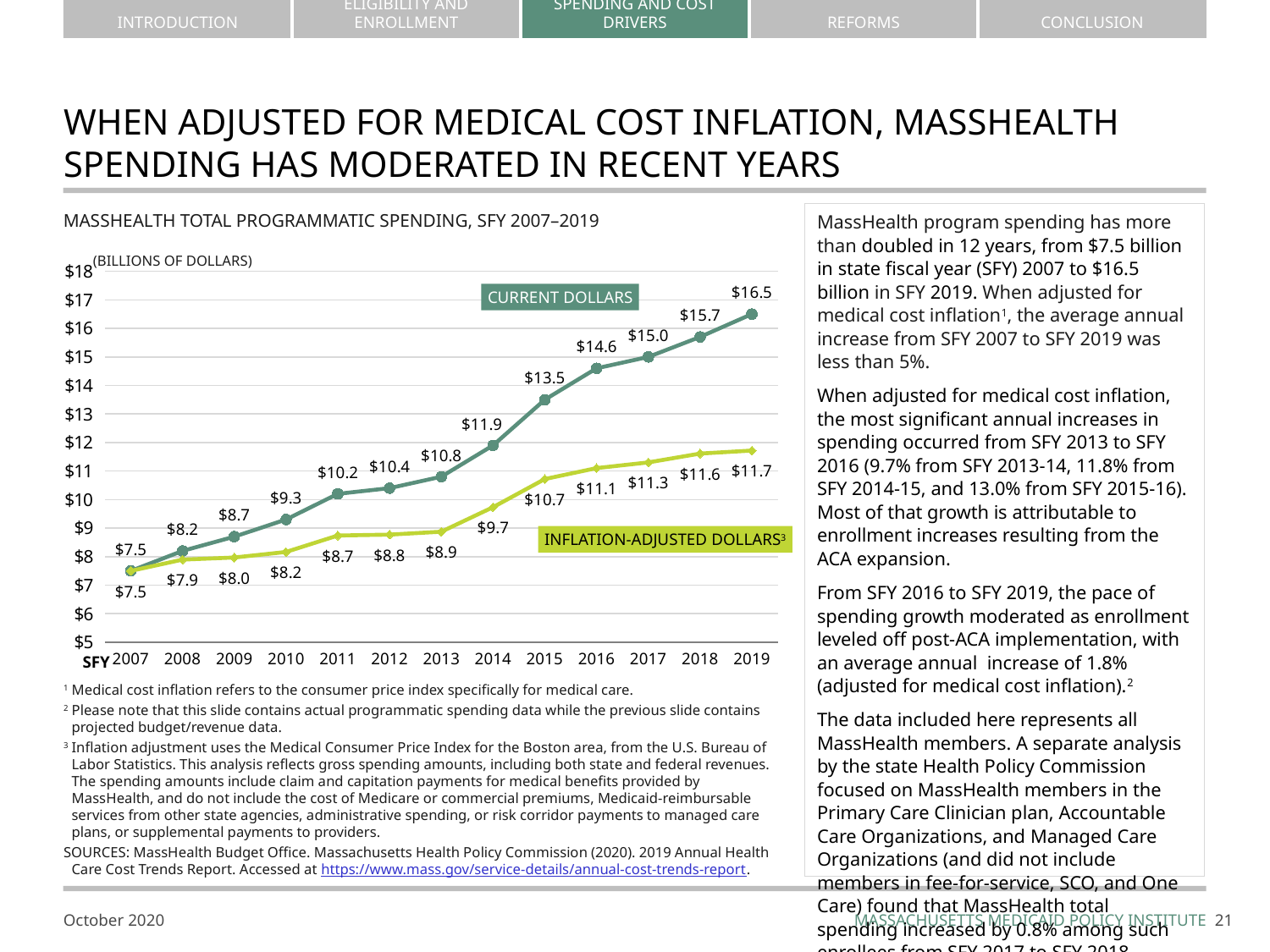
What was the current-dollar spending value for SFY 2014? $11.9 How many data series are plotted on the chart? 2 How many years (data points) are plotted for each series? 13 By how much did current-dollar spending increase from SFY 2007 to SFY 2019? $9.0 What was the inflation-adjusted spending value for SFY 2015? $10.7 Does the inflation-adjusted spending line rise or fall from SFY 2007 to SFY 2019? Rise In which year is the current-dollar spending highest? 2019 Which is larger in SFY 2016: current-dollar spending or inflation-adjusted spending? Current dollars What is the difference between current-dollar and inflation-adjusted spending in SFY 2019? $4.8 What was MassHealth total programmatic spending in current dollars in SFY 2019? $16.5 What type of chart is shown on the slide? Line chart In which year is the inflation-adjusted spending lowest? 2007